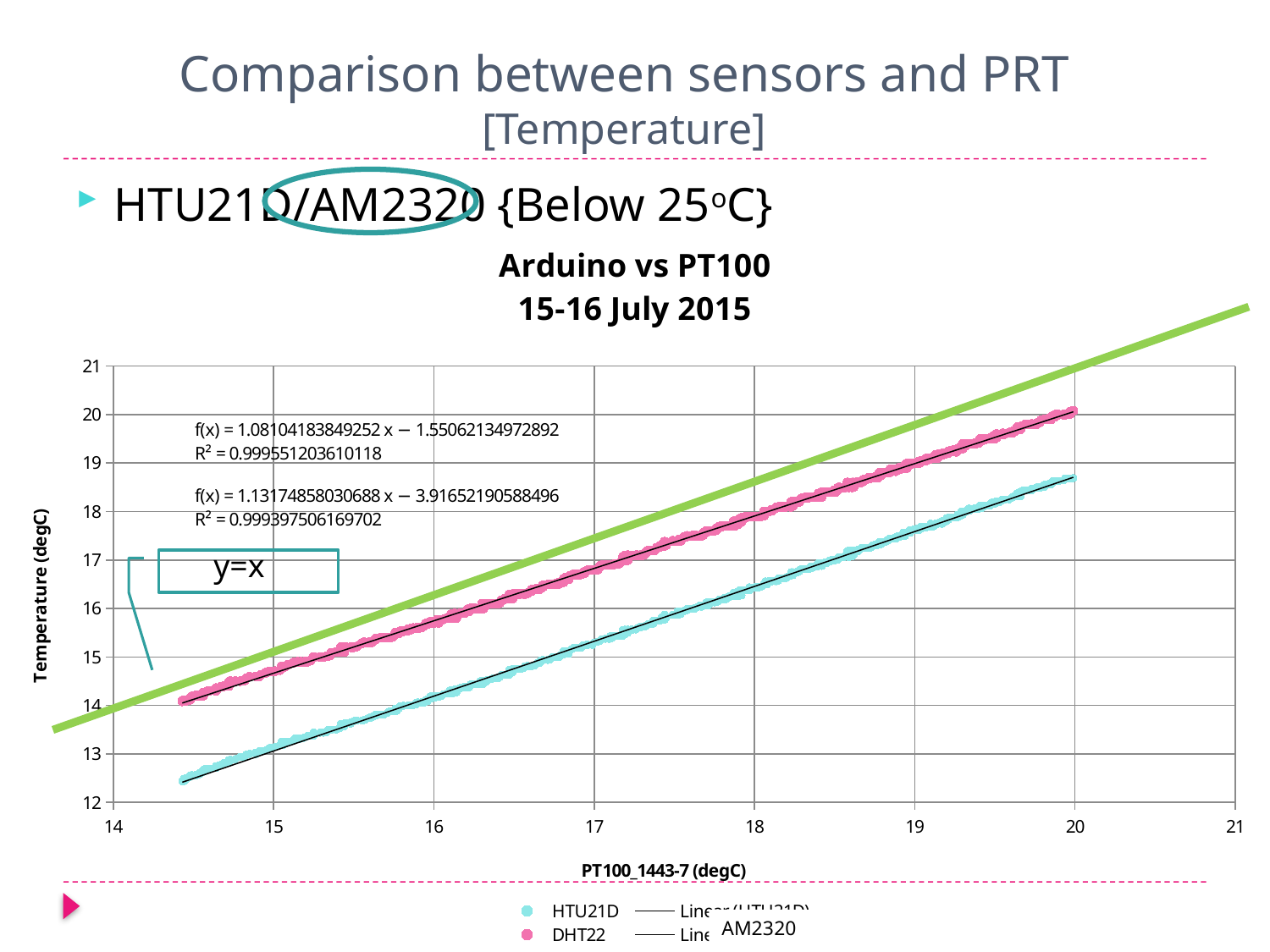
What is the R² value shown for the first trendline equation on the chart? 0.999551203610118 At a PT100 reading of 17 degC, which series shows the higher temperature, HTU21D or DHT22? DHT22 Is the HTU21D value at a PT100 reading of 15 degC greater or less than 14? less Which two sensor data series are listed in the chart legend? HTU21D and DHT22 What kind of chart is shown on the slide? Scatter chart What is the label of the x axis of the chart? PT100_1443-7 (degC) Is the DHT22 value at a PT100 reading of 19 degC greater or less than 18? greater What is the title of the chart? Arduino vs PT100 15-16 July 2015 What is the slope coefficient in the second trendline equation, f(x) = ... x − 3.91652190588496? 1.13174858030688 Do the HTU21D and DHT22 points lie above or below the green y=x reference line? Below Do the plotted temperature values rise or fall as the PT100 temperature increases along the x axis? Rise What is the R² value shown for the second trendline equation on the chart? 0.999397506169702